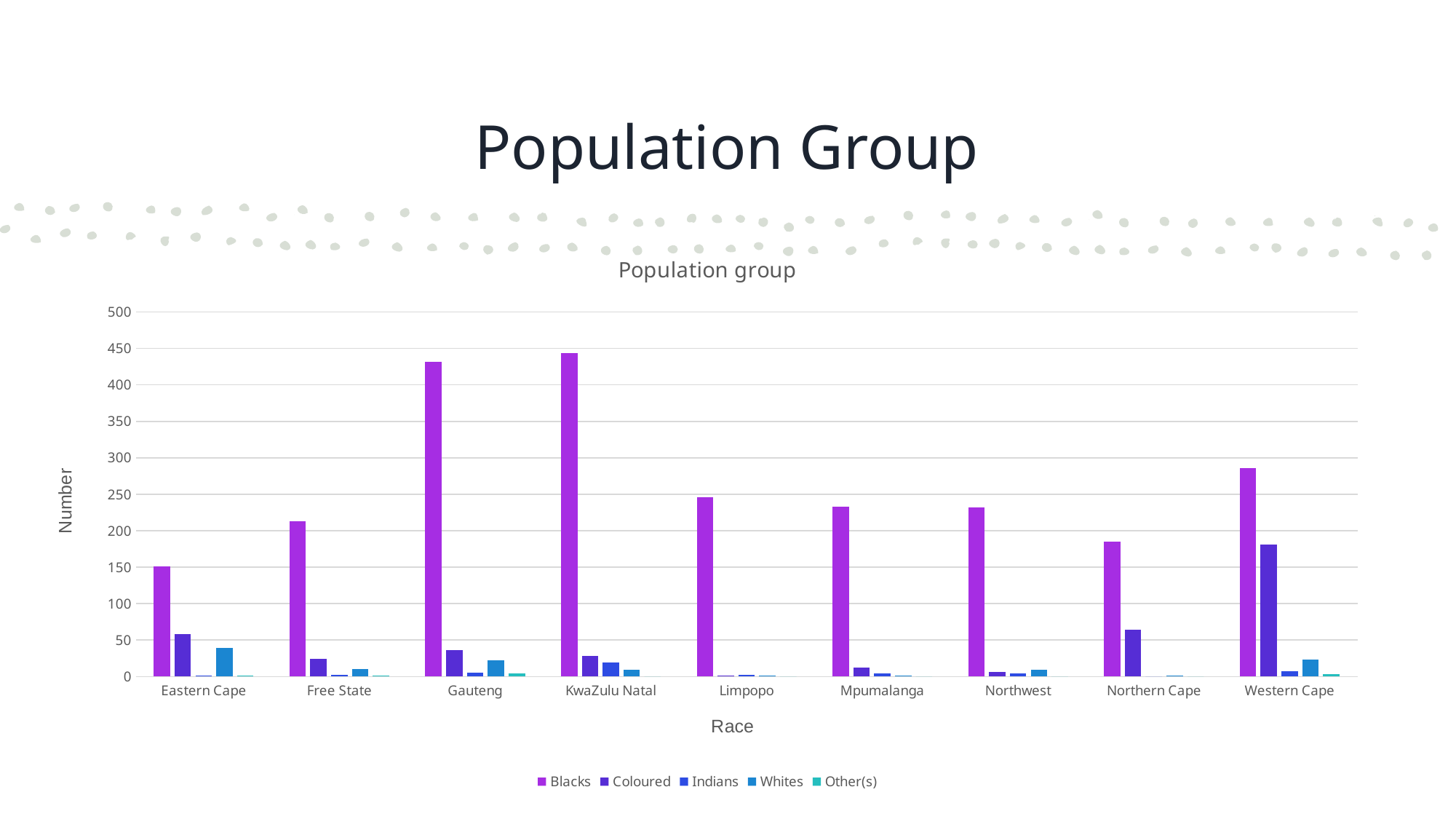
What kind of chart is shown on the slide? bar chart Is the value for Blacks in Gauteng greater or less than 400? greater How many provinces (categories) are shown on the x axis? 9 Which is larger: the value for Whites in Eastern Cape or in Free State? Eastern Cape How many series does the legend list? 5 Which province has the highest value for Coloured? Western Cape Which province has the lowest value for Blacks? Eastern Cape Is the value for Blacks in Western Cape greater or less than 300? less Which is larger: the value for Blacks in Western Cape or in Limpopo? Western Cape What is the label on the vertical axis of the chart? Number Is the value for Coloured in Western Cape greater or less than 150? greater